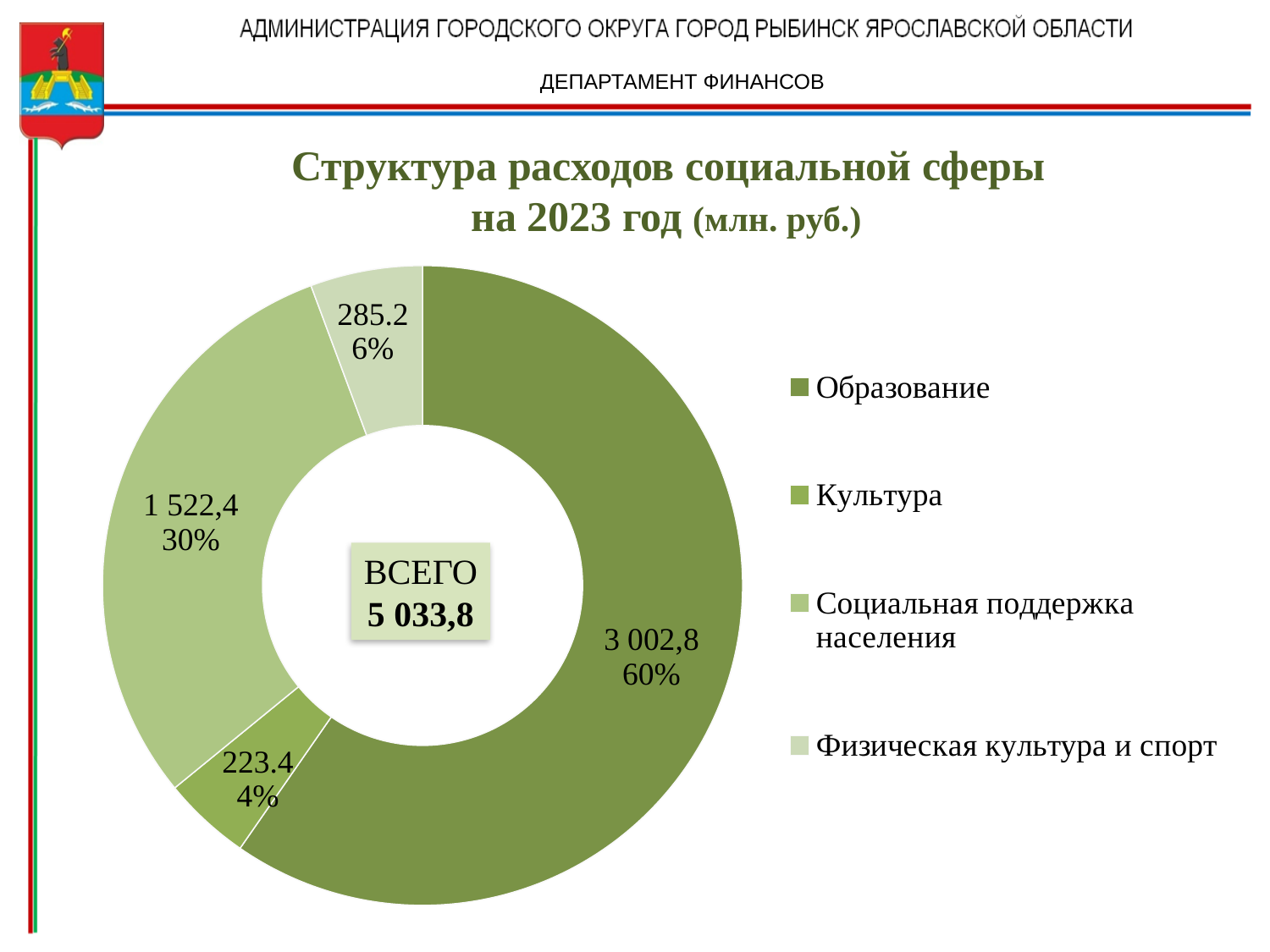
What type of chart is shown on the slide? Doughnut (pie) chart What is the value for Физическая культура и спорт? 285.2 What is the value for Социальная поддержка населения? 1 522,4 What is the value for Образование? 3 002,8 Which category has the smallest share of expenditure? Культура What share of the total does Социальная поддержка населения account for? 30% What total (ВСЕГО) is shown in the centre of the chart? 5 033,8 What share of the total does Физическая культура и спорт account for? 6% Which is larger: Физическая культура и спорт or Культура? Физическая культура и спорт Which category has the largest share of expenditure? Образование What is the value for Культура? 223.4 How many categories does the chart show? 4